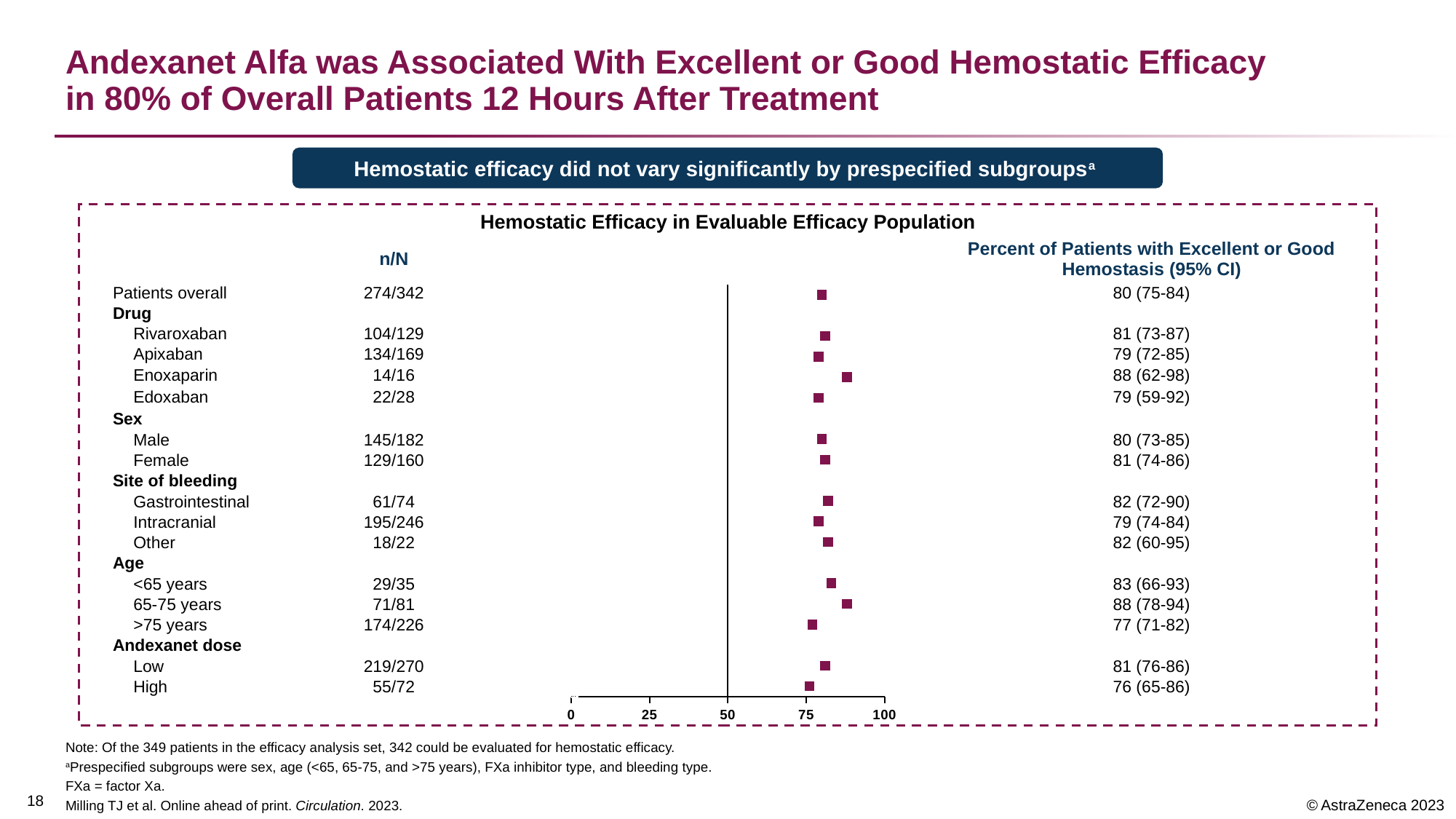
What is the percent of patients with excellent or good hemostasis for the High andexanet dose subgroup? 76 (65-86) Which subgroup has the lowest percent of patients with excellent or good hemostasis? High andexanet dose (76) How many rows (including Patients overall) are plotted as points in the chart? 15 What is the title of the chart? Hemostatic Efficacy in Evaluable Efficacy Population What is the difference in percent of patients with excellent or good hemostasis between the 65-75 years and >75 years subgroups? 11 What is the n/N value for the Intracranial site of bleeding subgroup? 195/246 Which has a higher percent of patients with excellent or good hemostasis, Gastrointestinal or Intracranial bleeding? Gastrointestinal Is the plotted value for the Enoxaparin subgroup greater or less than 75? greater What kind of chart is used to display the hemostatic efficacy results? forest plot What is the percent of patients with excellent or good hemostasis for Patients overall? 80 (75-84) What is the highest tick value shown on the x axis of the chart? 100 What is the percent of patients with excellent or good hemostasis for the Enoxaparin subgroup? 88 (62-98)